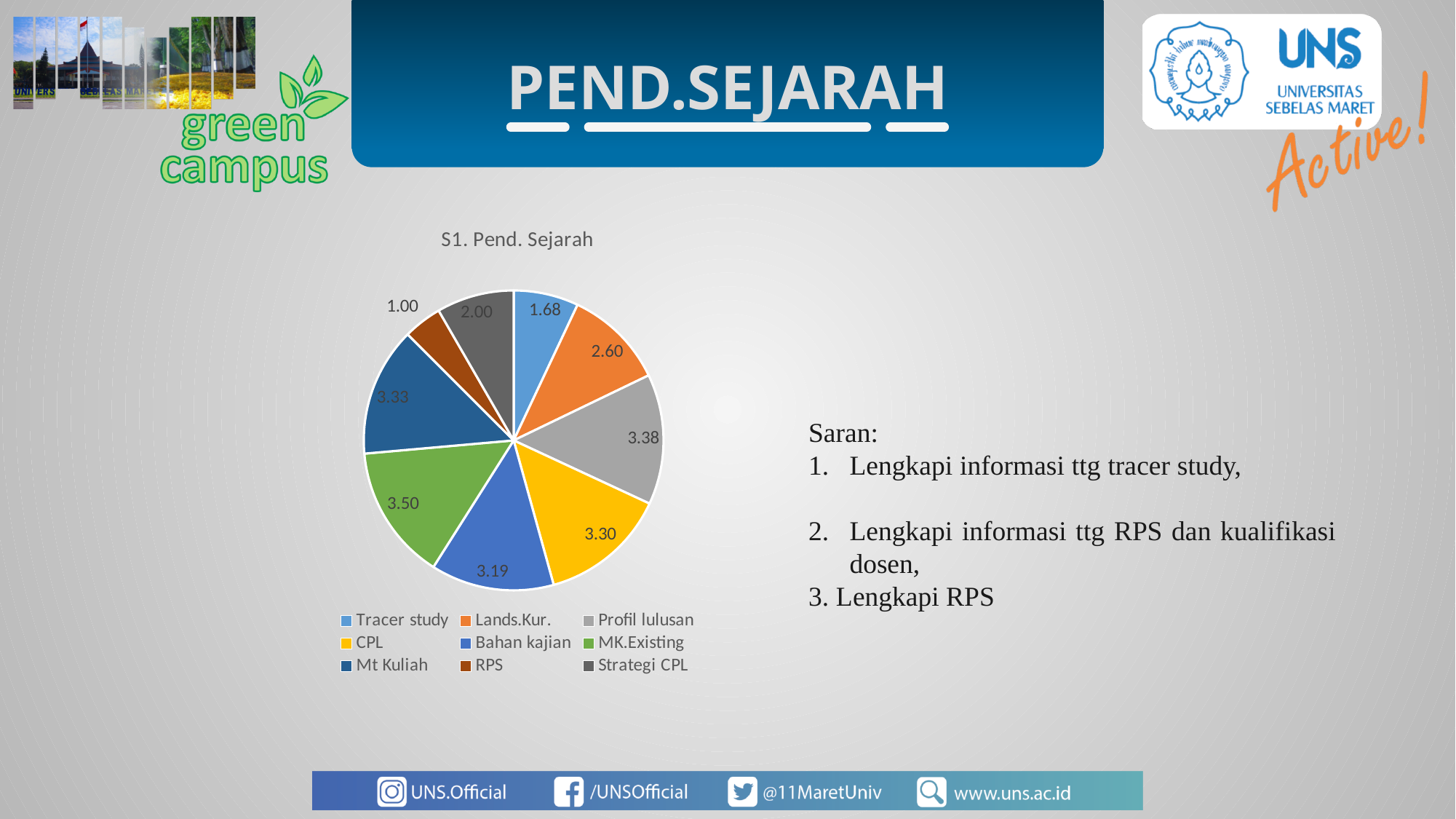
What is the difference between the values for MK.Existing and RPS? 2.50 What is the value for Strategi CPL? 2.00 What is the value for Bahan kajian? 3.19 What is the title of the chart? S1. Pend. Sejarah Which category has the highest value? MK.Existing What is the value for Profil lulusan? 3.38 What colour is the Mt Kuliah slice? dark blue Which category has the lowest value? RPS What is the value for Tracer study? 1.68 How many categories does the pie chart have? 9 Which is larger, the value for CPL or the value for Lands.Kur.? CPL What kind of chart is shown on the slide? pie chart